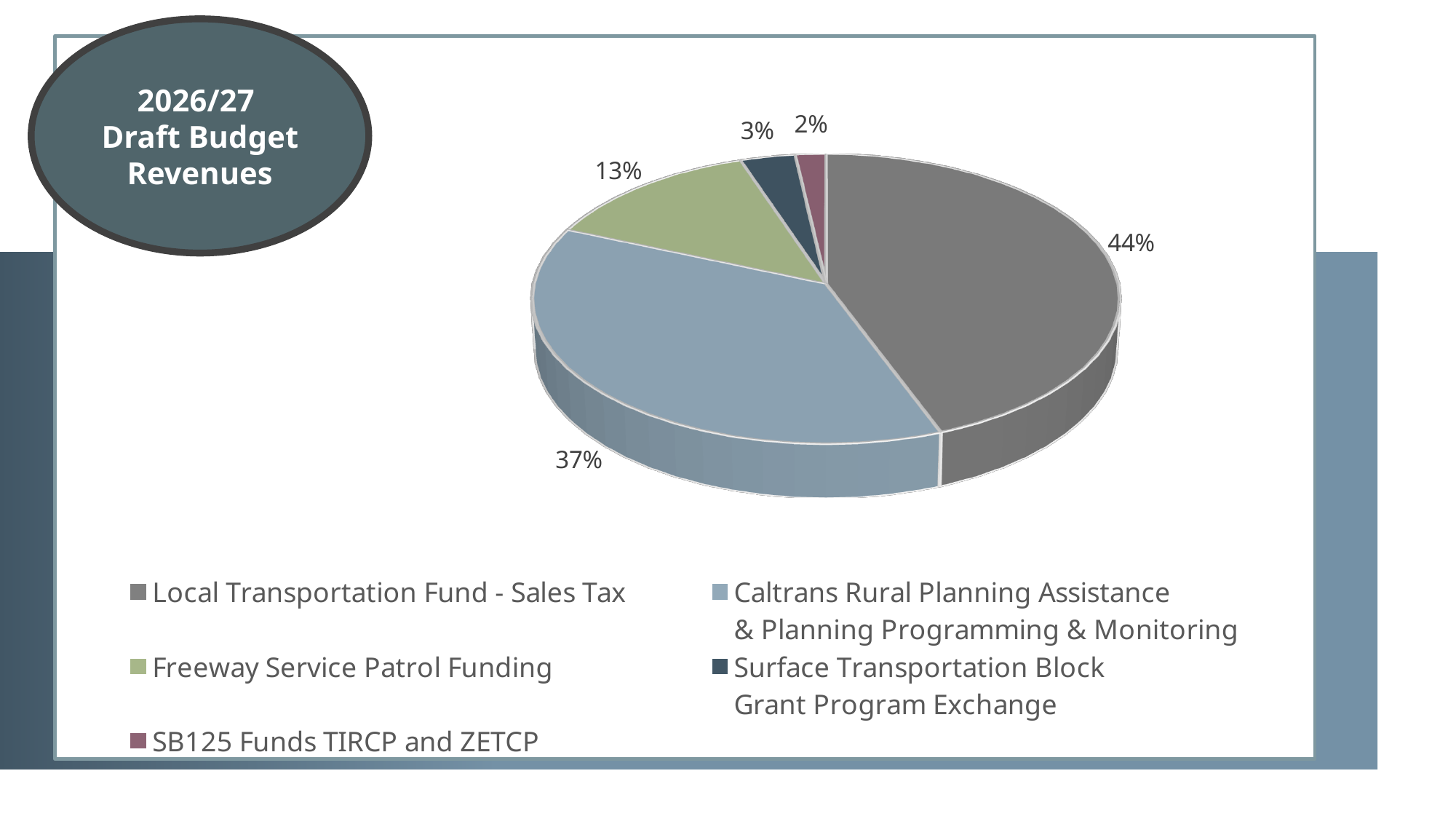
What share of the pie does Surface Transportation Block Grant Program Exchange represent? 3% Which revenue source has the smallest share of the pie? SB125 Funds TIRCP and ZETCP What share of the pie does SB125 Funds TIRCP and ZETCP represent? 2% How many slices does the pie chart have? 5 What share of the pie does Caltrans Rural Planning Assistance & Planning Programming & Monitoring represent? 37% What kind of chart is shown on the slide? Pie chart What is the difference in percentage points between the Local Transportation Fund - Sales Tax share and the Caltrans Rural Planning Assistance & Planning Programming & Monitoring share? 7 percentage points What is the title shown in the oval on the slide? 2026/27 Draft Budget Revenues Which is larger: the share for Freeway Service Patrol Funding or the share for Surface Transportation Block Grant Program Exchange? Freeway Service Patrol Funding Which revenue source has the largest share of the pie? Local Transportation Fund - Sales Tax